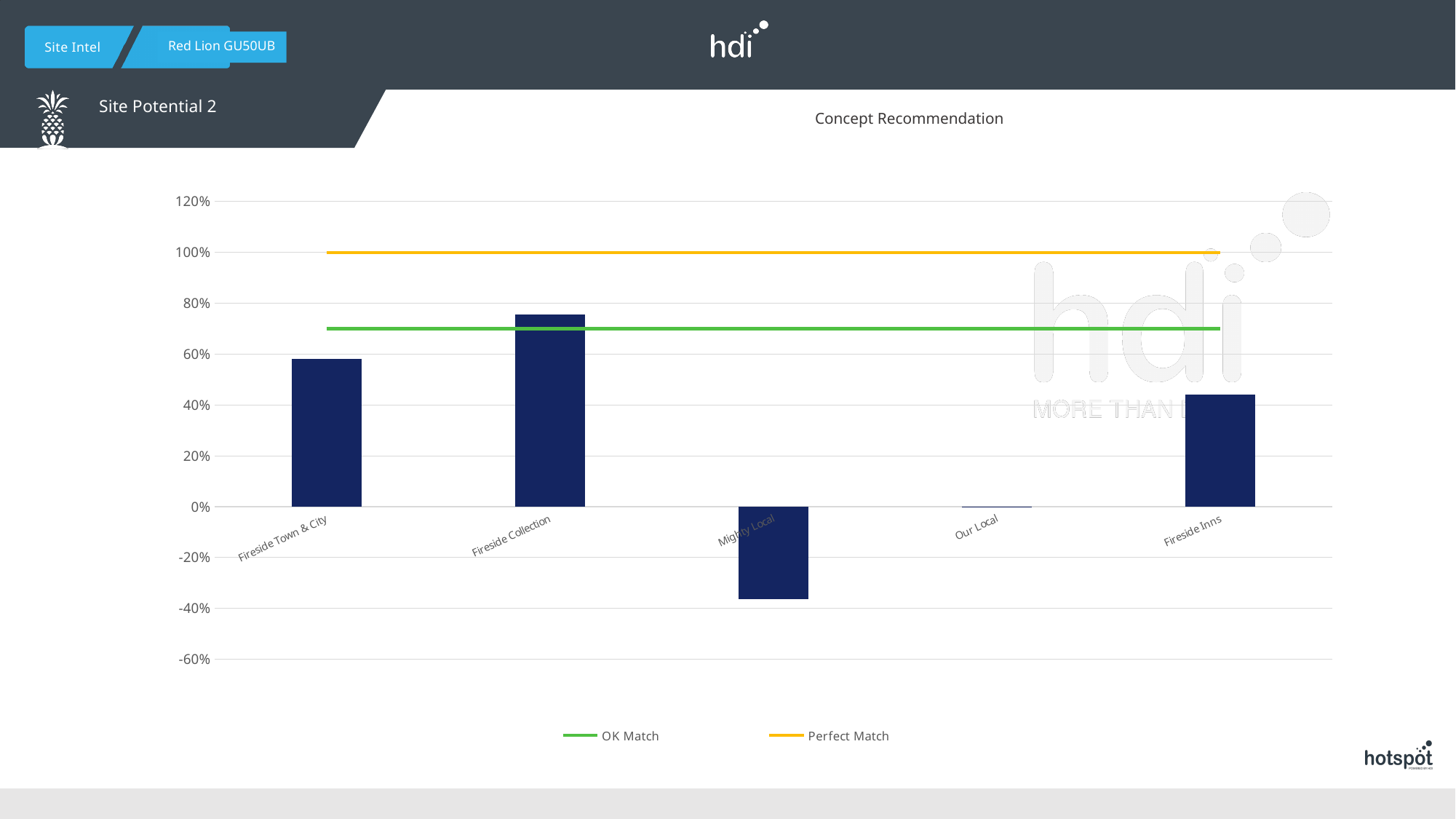
Is the value for Fireside Collection greater or less than 60%? greater What colour is the OK Match line in the chart? green What is the title shown above the chart? Concept Recommendation Is the value for Mighty Local greater or less than -20%? less What kind of chart is shown on the slide? bar chart At what value does the Perfect Match line sit on the chart? 100% Which is larger, the value for Fireside Town & City or the value for Fireside Inns? Fireside Town & City Which category has the lowest bar in the chart? Mighty Local Which category has the highest bar in the chart? Fireside Collection Is the value for Fireside Inns greater or less than 60%? less How many entries does the chart's legend list? 2 How many categories are shown on the x axis of the chart? 5